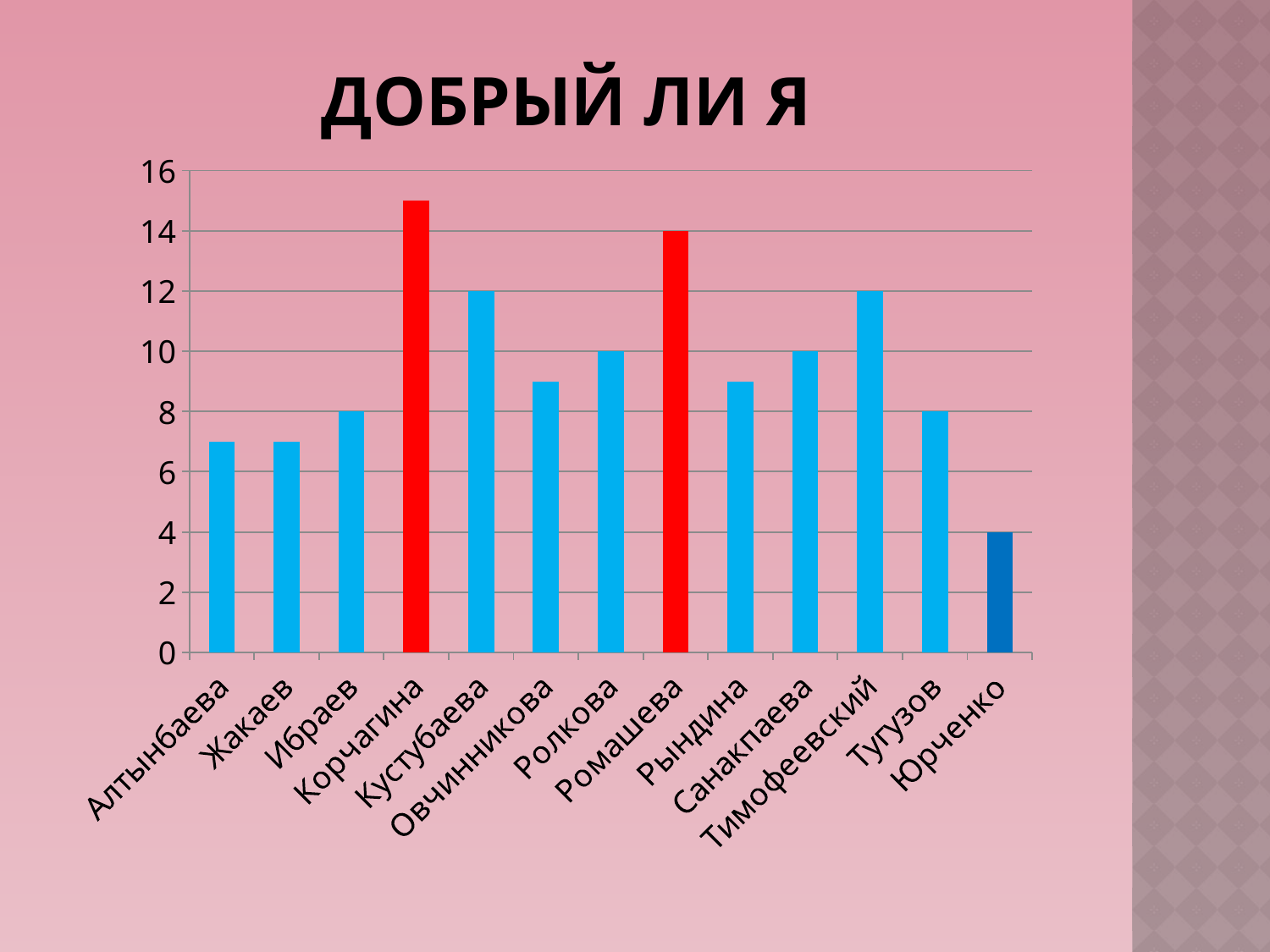
Is the value for Корчагина greater or less than 14? greater What is the value for Юрченко? 4 What is the title of the chart? ДОБРЫЙ ЛИ Я What is the value for Ромашева? 14 What is the value for Кустубаева? 12 What kind of chart is shown on the slide? bar chart Which person has the lowest bar? Юрченко Which is larger, the value for Ролкова or the value for Овчинникова? Ролкова What is the difference between the values for Тимофеевский and Тугузов? 4 How many people (categories) are shown on the x axis? 13 Is the value for Алтынбаева greater or less than 8? less Which person has the highest bar? Корчагина